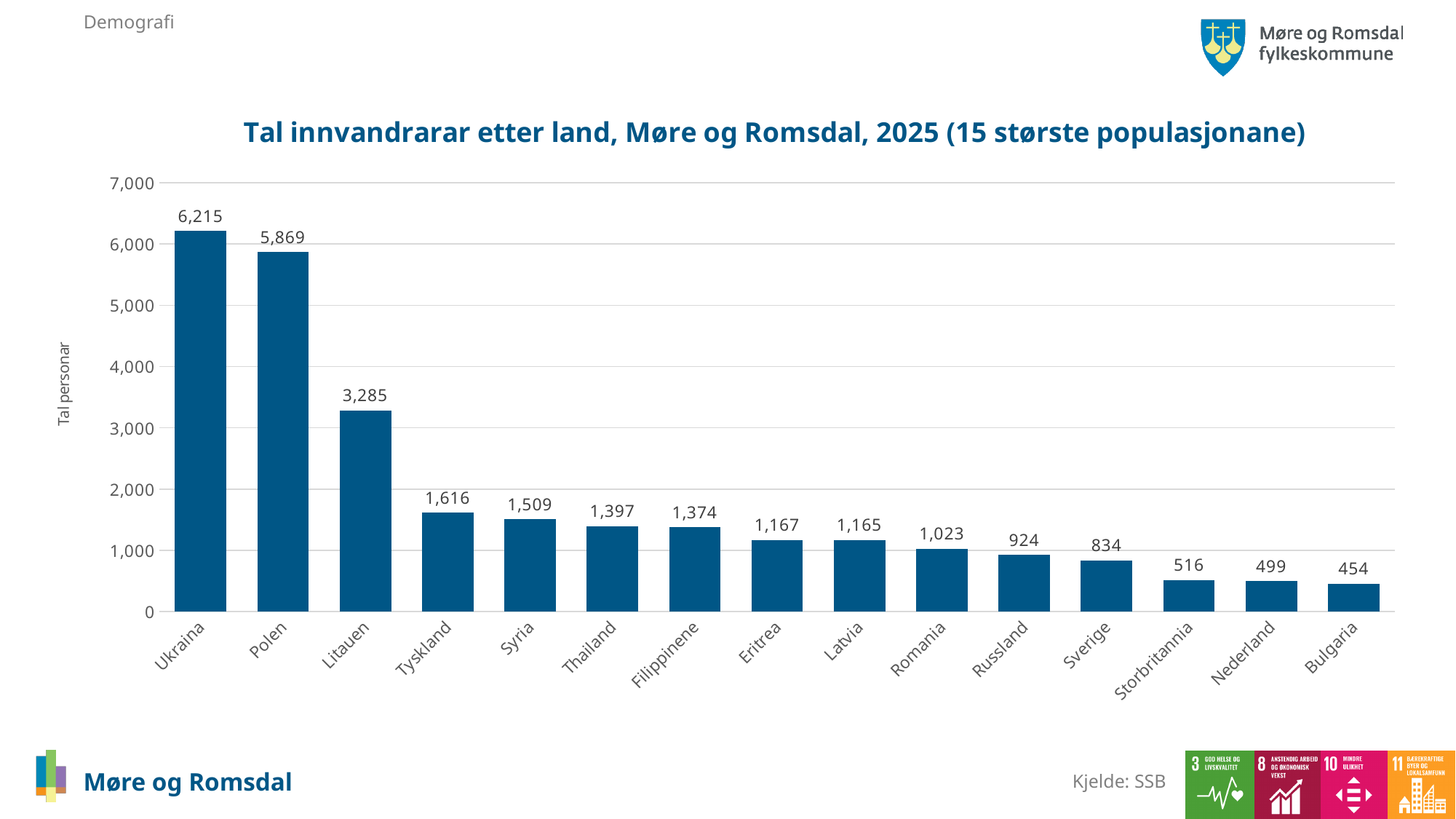
How many countries are shown in the chart? 15 Which country has the highest value? Ukraina What is the title of the chart? Tal innvandrarar etter land, Møre og Romsdal, 2025 (15 største populasjonane) What kind of chart is shown on the slide? Bar chart What is the difference between the values for Ukraina and Polen? 346 Is the value for Romania greater or less than 1,000? greater Which is larger, the value for Syria or the value for Thailand? Syria What is the value for Sverige? 834 What is the value for Ukraina? 6,215 Which country has the lowest value? Bulgaria What is the value for Tyskland? 1,616 What is the difference between the values for Litauen and Tyskland? 1,669